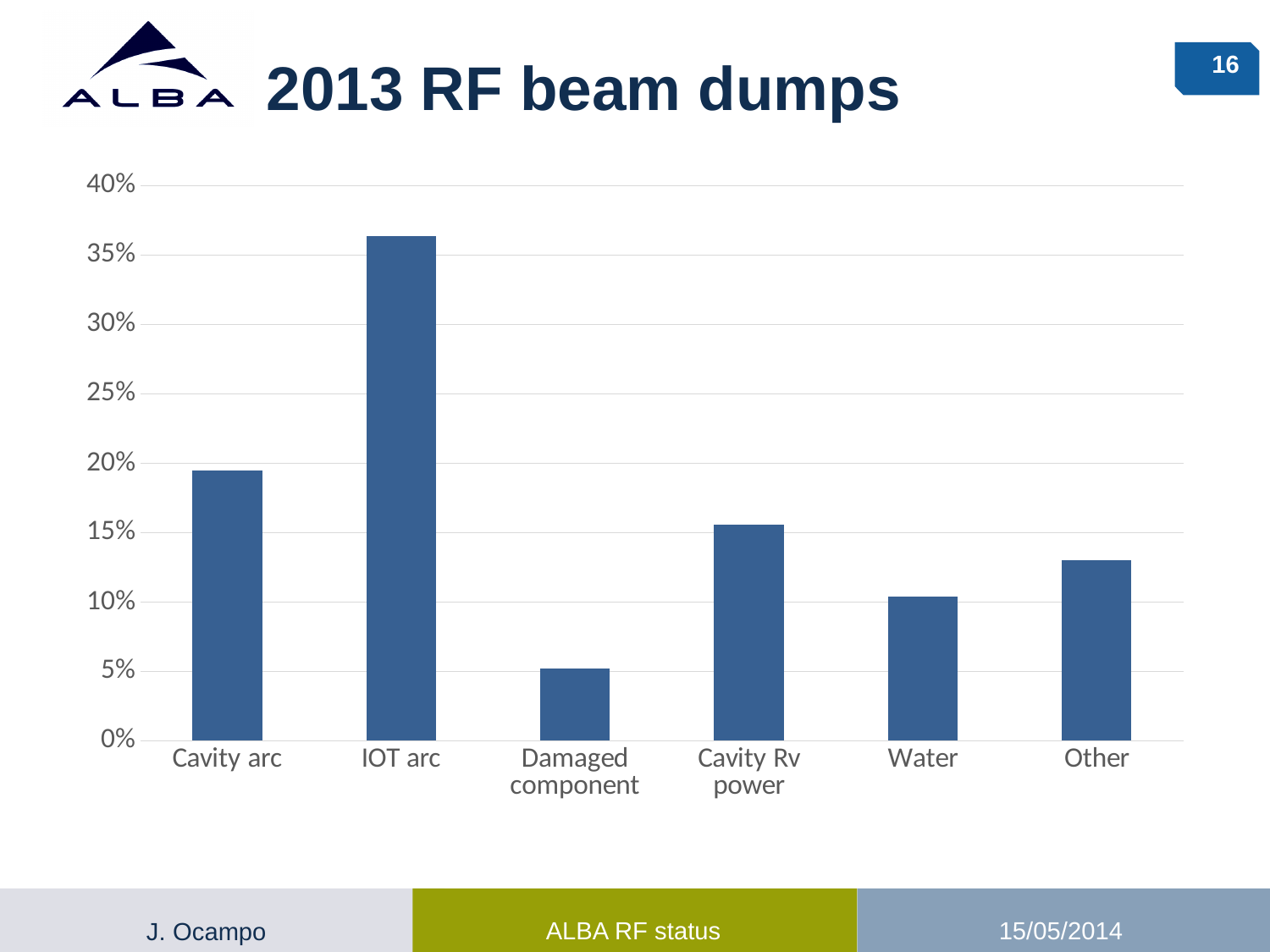
What kind of chart is shown on the slide? bar chart Is the value for IOT arc greater or less than 30%? greater Is the value for Other greater or less than 10%? greater Is the value for Water greater or less than 15%? less Which is larger, the value for Cavity arc or the value for Cavity Rv power? Cavity arc Which category has the highest value? IOT arc What is the title of the chart? 2013 RF beam dumps Which category has the lowest value? Damaged component Which is larger, the value for Water or the value for Other? Other How many categories are shown on the x axis of the chart? 6